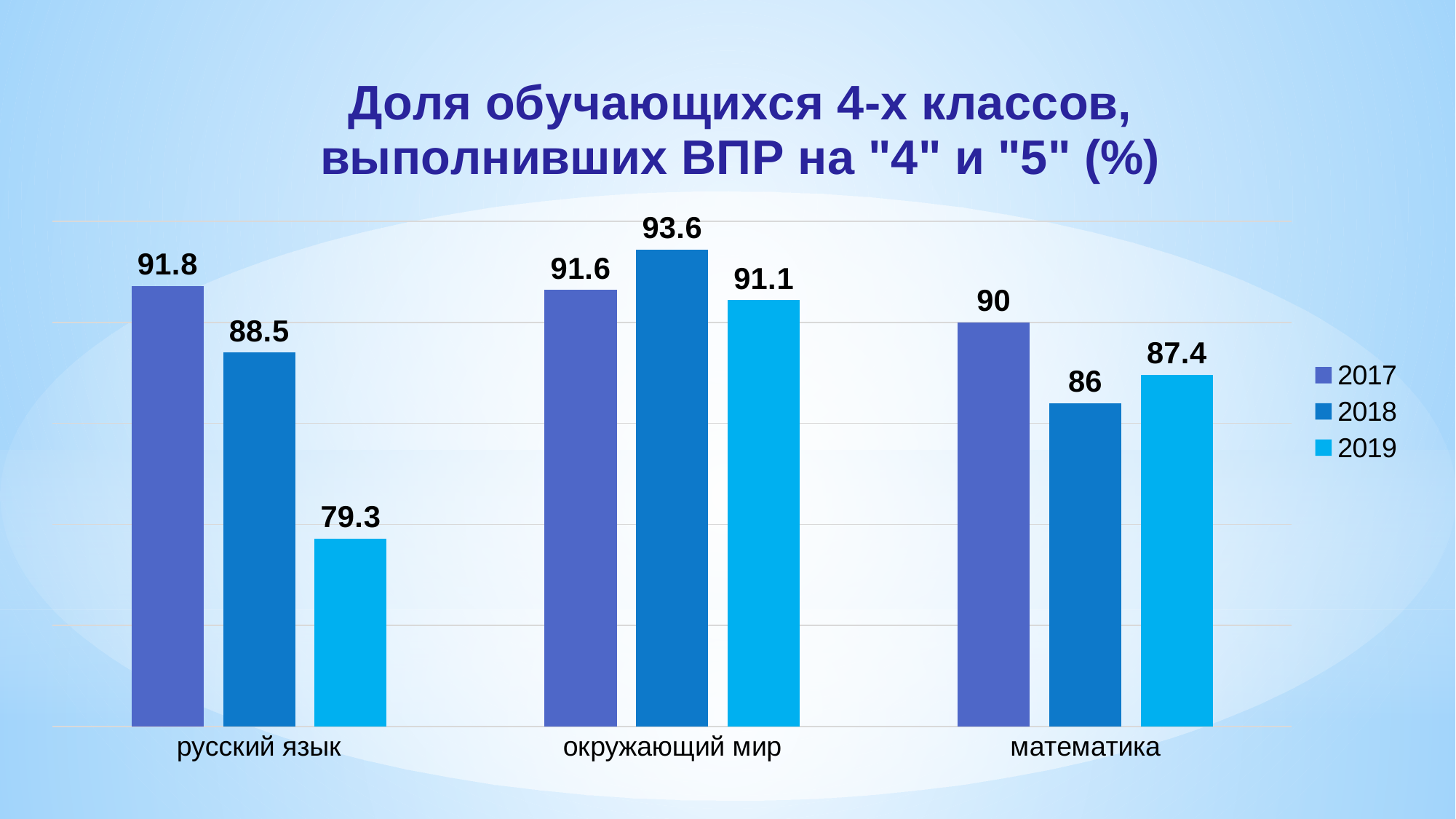
Which years are listed in the legend? 2017, 2018, 2019 What kind of chart is shown on the slide? bar chart What is the difference between the 2018 and 2019 values for математика? 1.4 Which subject has the highest value in 2018? окружающий мир How many subjects (categories) are shown on the x axis? 3 What is the value for математика in 2017? 90 What is the value for окружающий мир in 2018? 93.6 Which subject has the lowest value in 2019? русский язык How many series does the legend list? 3 What is the value for русский язык in 2019? 79.3 Which is larger for математика: the 2017 value or the 2018 value? 2017 What is the difference between the 2017 and 2019 values for русский язык? 12.5